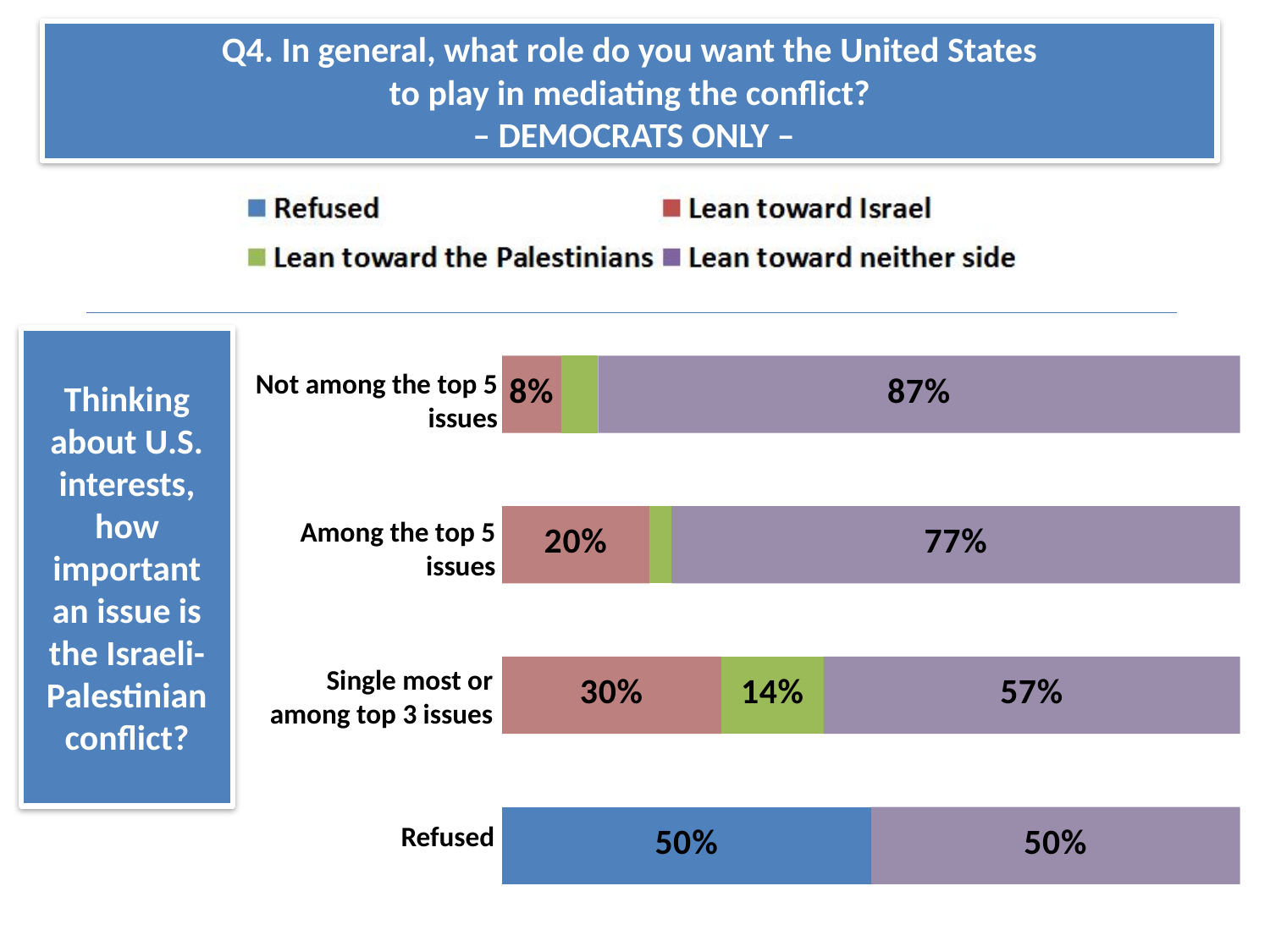
What is the 'Lean toward Israel' value for the 'Not among the top 5 issues' group? 8% What percentage of Democrats who say the conflict is the single most or among the top 3 issues want the U.S. to lean toward neither side? 57% Which group has the lowest 'Lean toward Israel' percentage among the three issue-importance groups? Not among the top 5 issues How many categories (bars) are shown in the chart? 4 What percentage of Democrats who say the conflict is not among the top 5 issues want the U.S. to lean toward neither side? 87% How many series does the legend list? 4 What kind of chart is shown on the slide? Stacked bar chart What is the difference between the 'Lean toward Israel' values for the 'Single most or among top 3 issues' group and the 'Among the top 5 issues' group? 10% What percentage of Democrats who say the conflict is among the top 5 issues want the U.S. to lean toward Israel? 20% Which is larger: the 'Lean toward neither side' value for 'Among the top 5 issues' or for 'Single most or among top 3 issues'? Among the top 5 issues What percentage of Democrats who say the conflict is the single most or among the top 3 issues want the U.S. to lean toward the Palestinians? 14% Which group has the highest 'Lean toward neither side' percentage? Not among the top 5 issues